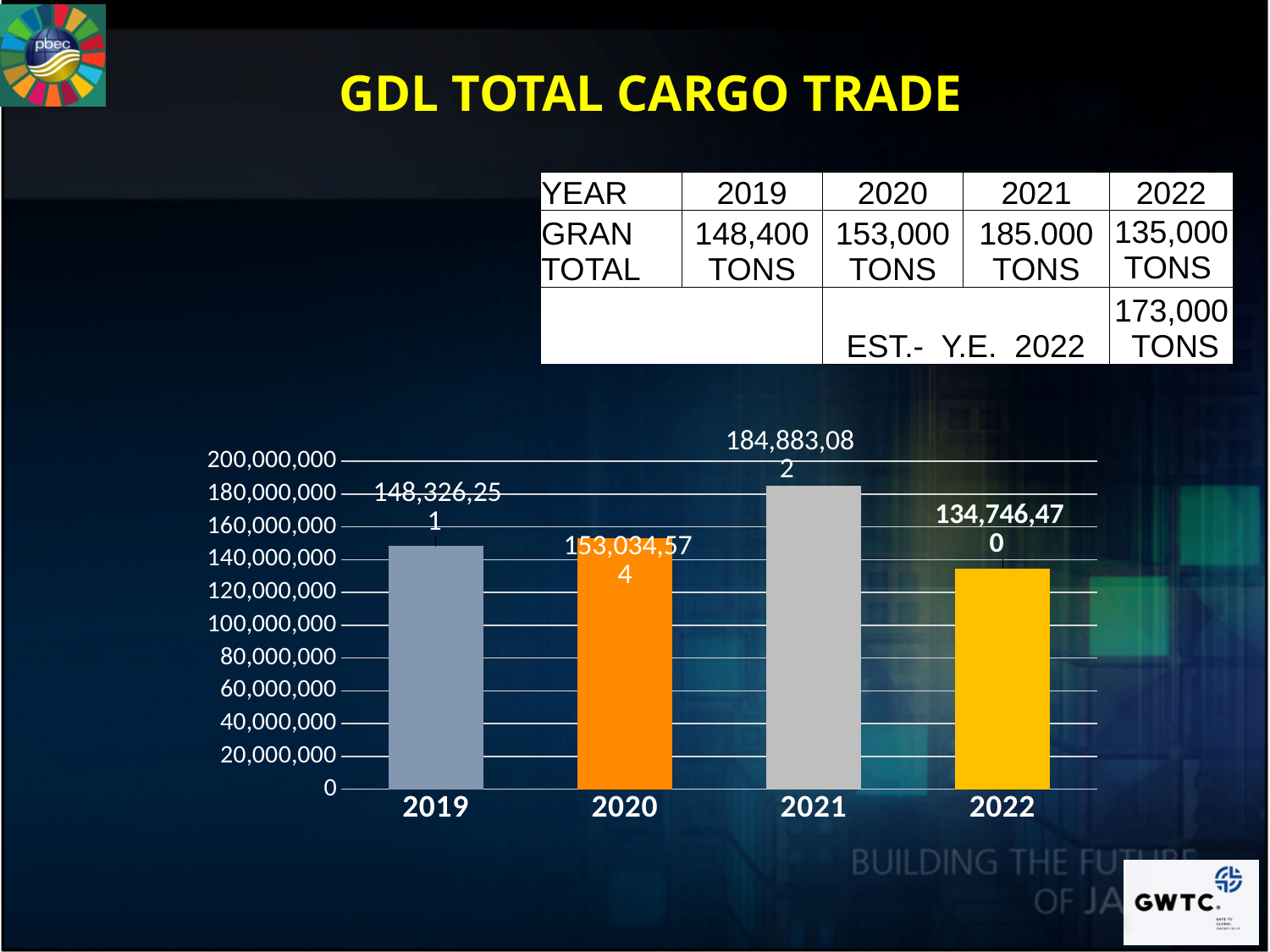
What kind of chart is shown on the slide? bar chart How many bars are shown in the chart? 4 Does the value rise or fall from 2021 to 2022? fall Which is larger, the value for 2020 or the value for 2019? 2020 What is the difference between the 2021 value and the 2022 value? 50,136,612 What is the value of the bar for 2019? 148,326,251 Is the value for 2020 greater or less than 140,000,000? greater What is the value of the bar for 2022? 134,746,470 What is the value of the bar for 2021? 184,883,082 Which year has the lowest bar? 2022 Which year has the highest bar? 2021 What colour is the bar for 2020? orange